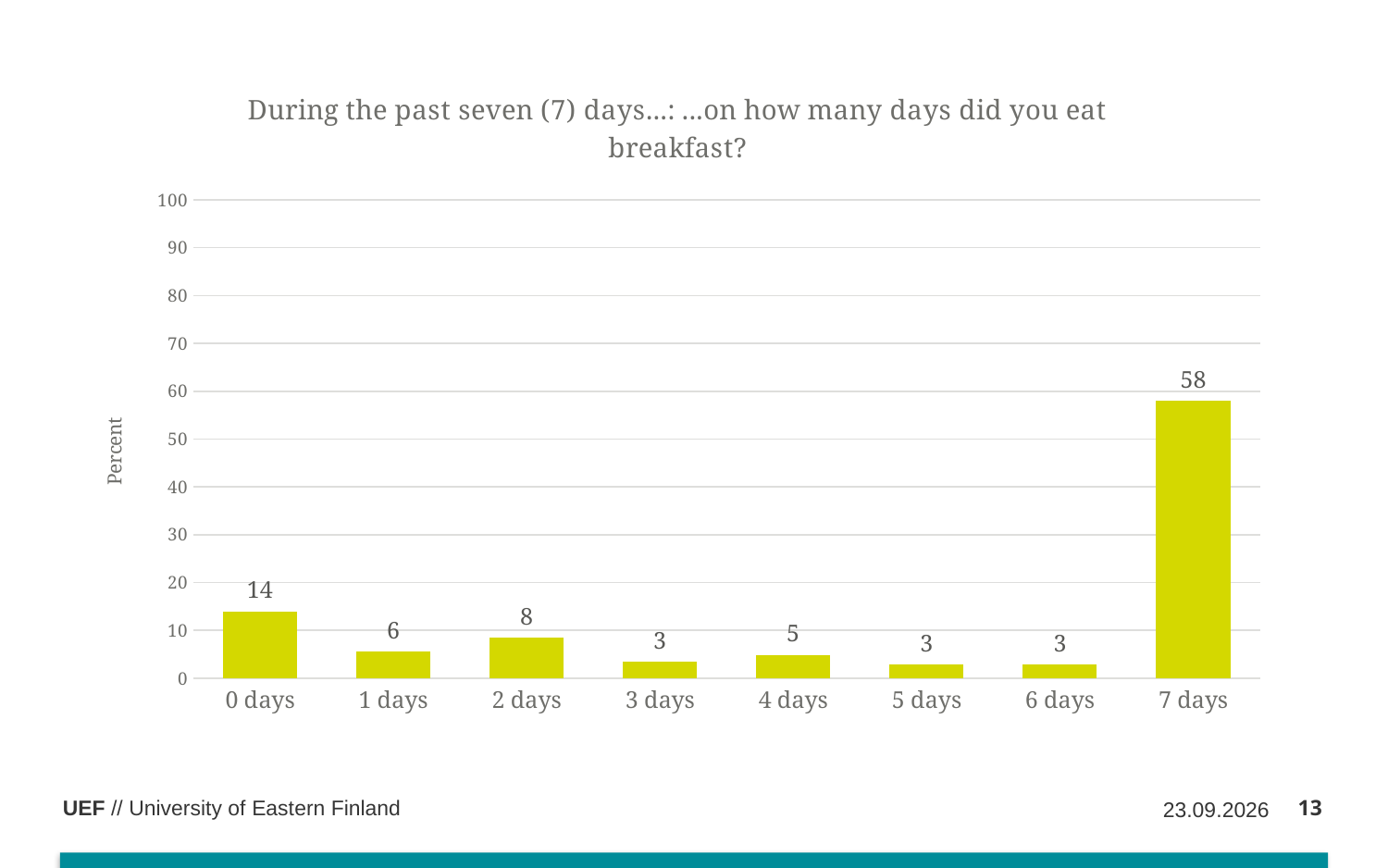
What kind of chart is this? bar chart Is the value for 7 days greater or less than 50? greater What is the value for 4 days? 5 Which is larger, the value for 1 days or the value for 2 days? 2 days What is the difference between the values for 7 days and 0 days? 44 What is the value for 2 days? 8 How many categories are shown on the x axis? 8 What is the value for 0 days? 14 What is the difference between the values for 0 days and 1 days? 8 What is the value for 7 days? 58 Which category has the highest value? 7 days What is the label of the y axis? Percent